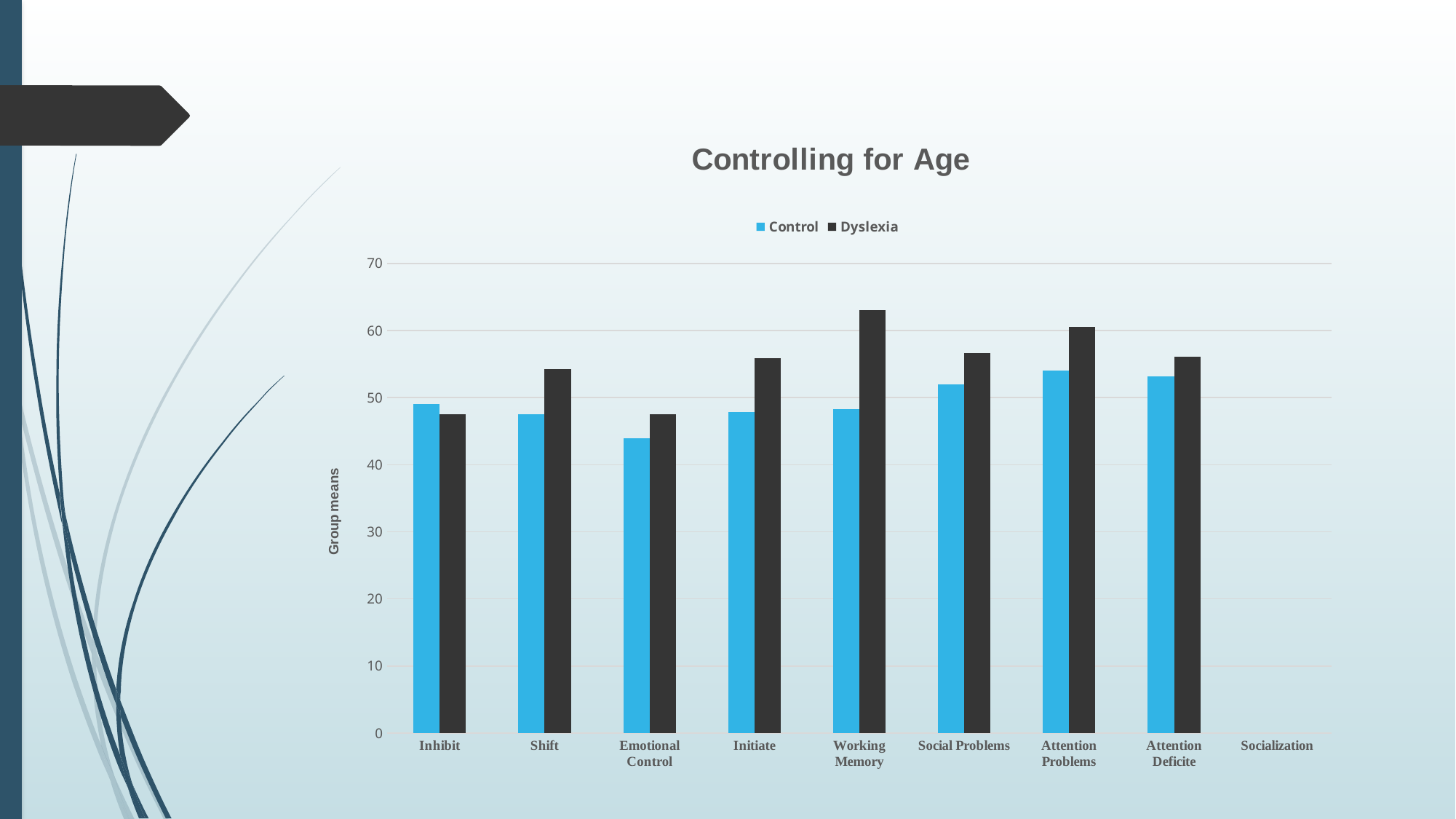
Is the Dyslexia value for Initiate greater or less than 50? greater What kind of chart is shown on the slide? bar chart What is the label on the vertical axis? Group means Is the Control value for Social Problems greater or less than 50? greater How many series does the legend list? 2 Is the Control value for Emotional Control greater or less than 50? less For Shift, which series has the larger value, Control or Dyslexia? Dyslexia Which category has the lowest Control value? Emotional Control How many categories are labelled on the x axis? 9 What is the title of the chart? Controlling for Age Which category has the highest Dyslexia value? Working Memory